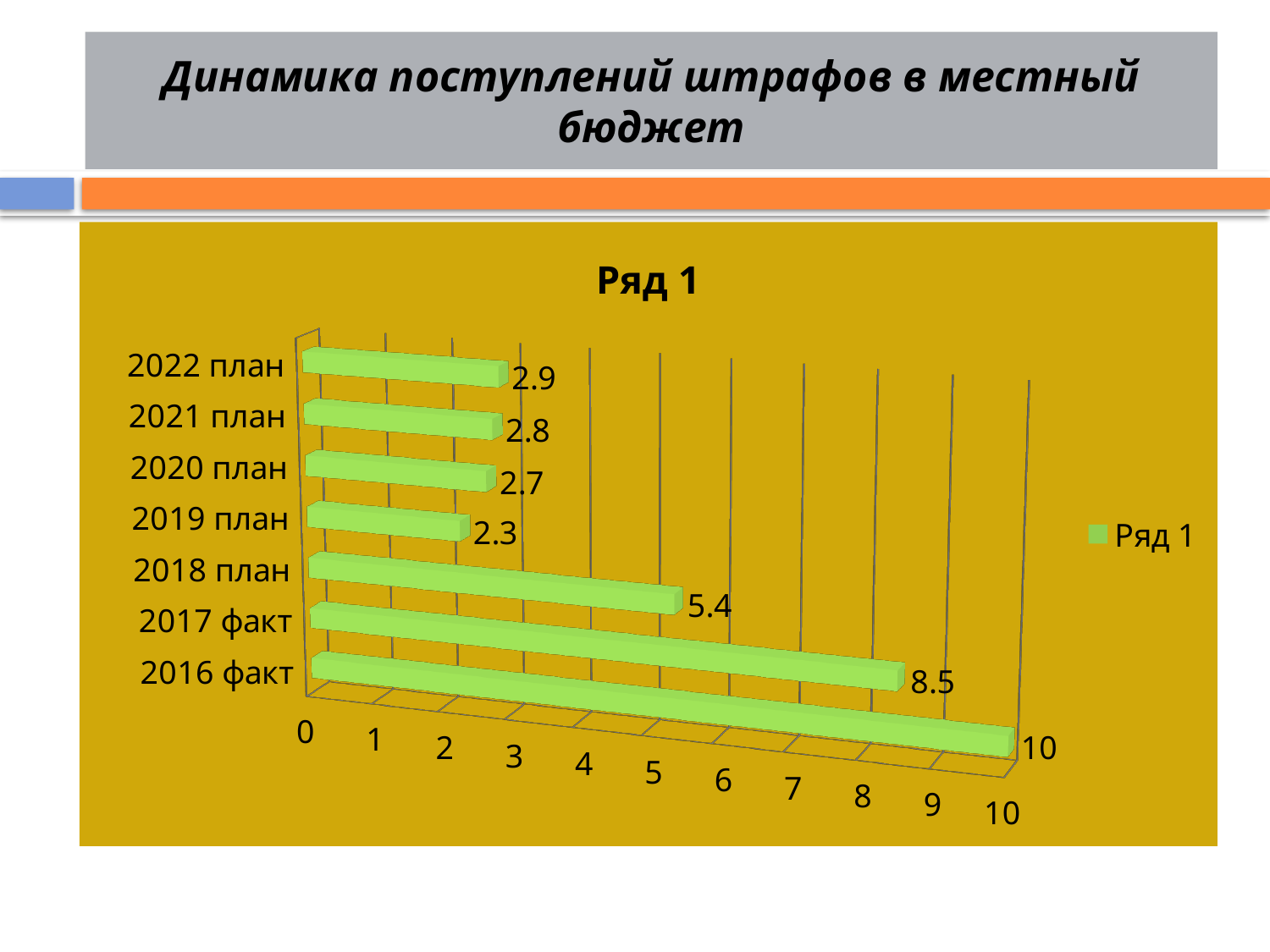
Is the value for 2017 факт greater or less than 8? greater What is the difference between the values for 2016 факт and 2017 факт? 1.5 How many series does the legend list? 1 What is the difference between the values for 2018 план and 2019 план? 3.1 Which is larger, the value for 2017 факт or the value for 2018 план? 2017 факт What kind of chart is shown on the slide? bar chart What is the value for 2016 факт? 10 What is the value for 2022 план? 2.9 Which category has the lowest value? 2019 план What is the value for 2018 план? 5.4 How many categories are shown in the chart? 7 Which category has the highest value? 2016 факт